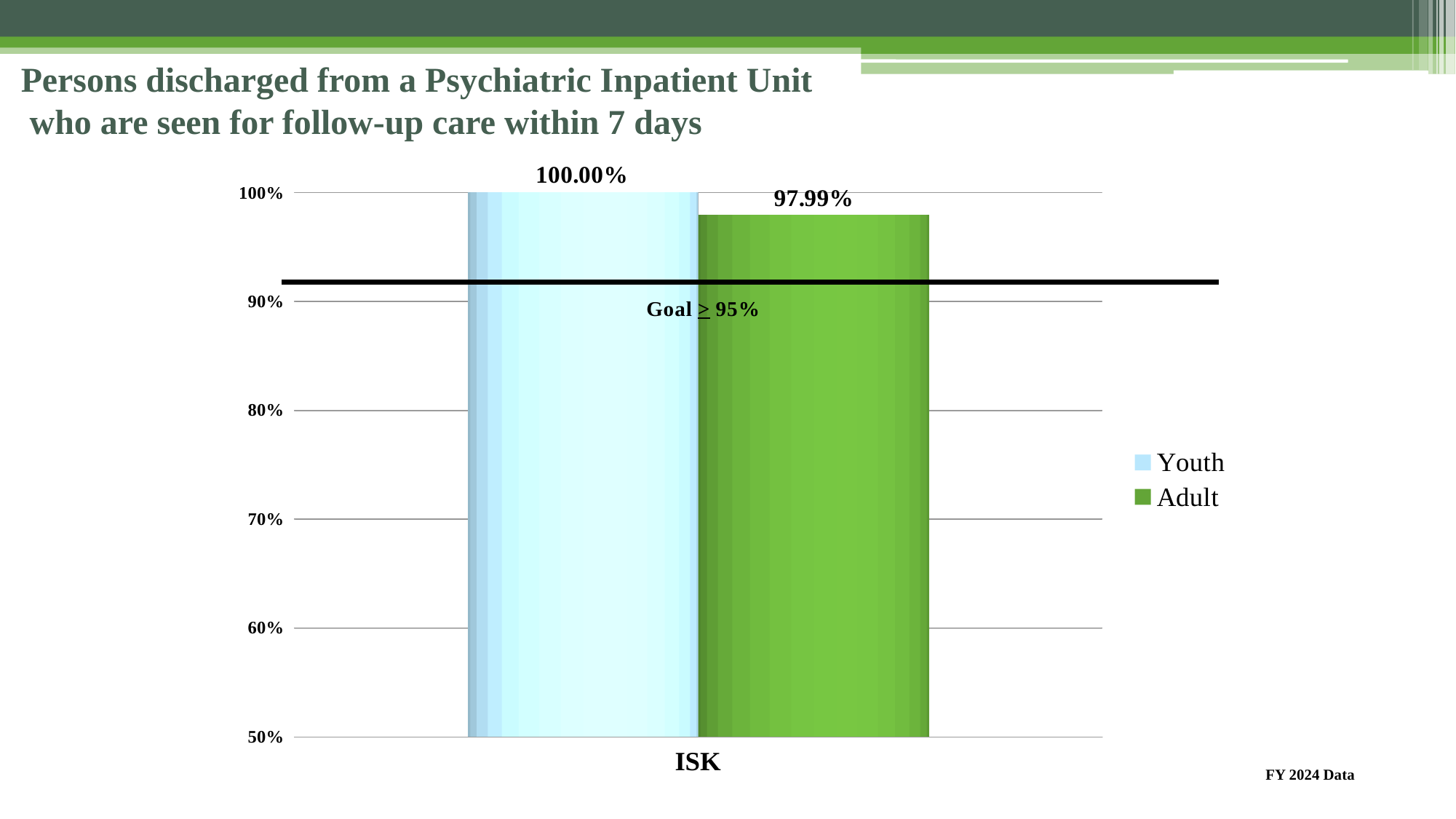
Which series has the higher value at ISK, Youth or Adult? Youth What is the value for Youth at ISK? 100.00% What is the label of the category on the x axis? ISK What is the difference between the Youth and Adult values at ISK? 2.01% What goal is marked by the horizontal line on the chart? Goal ≥ 95% What is the value for Adult at ISK? 97.99% What is the lowest value shown on the y axis? 50% What kind of chart is shown on the slide? Bar chart How many series does the legend list? 2 Which series has the lowest value on the chart? Adult Is the value for Adult at ISK greater or less than 90%? greater How many categories are shown on the x axis? 1